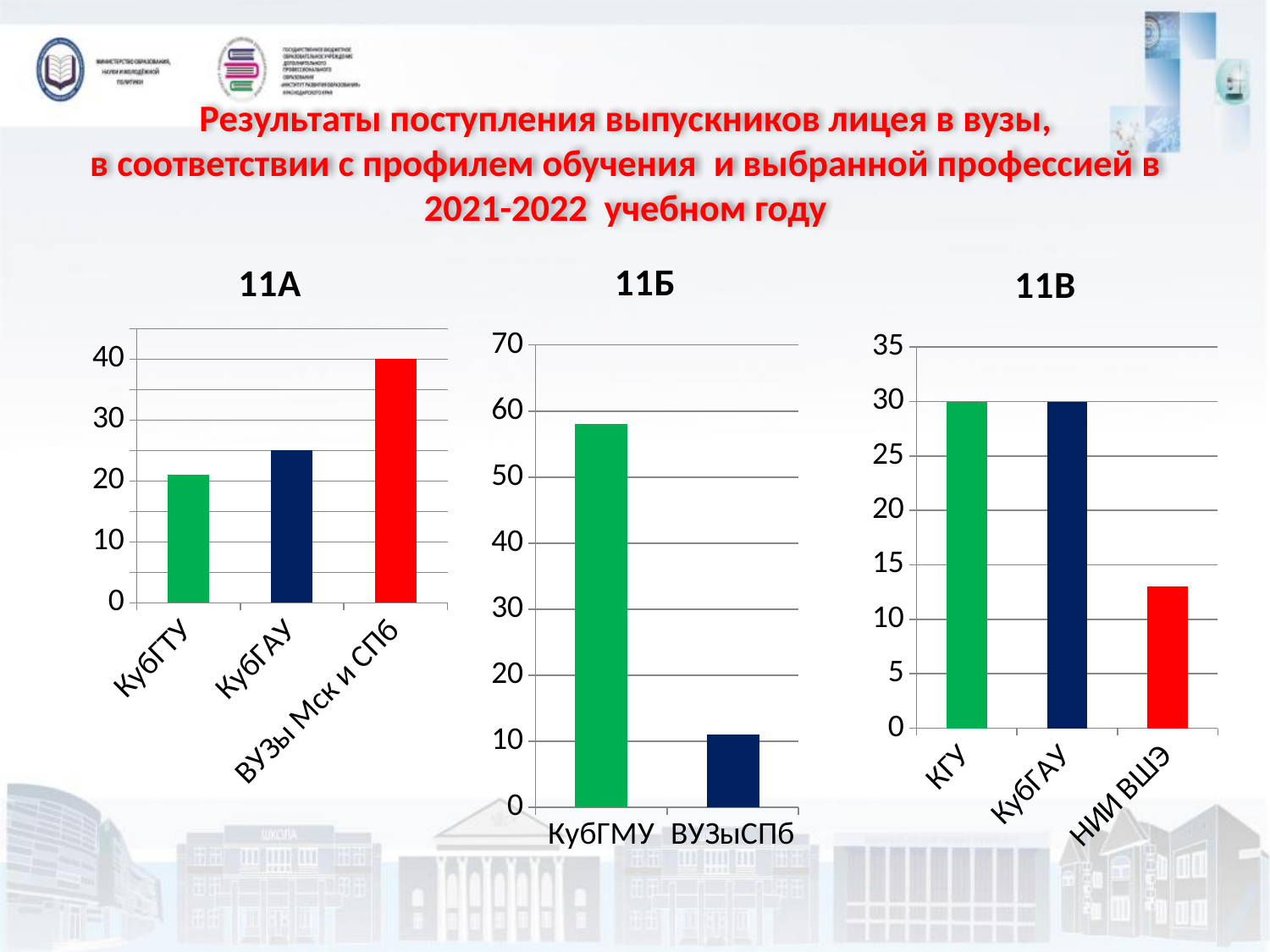
On the 11А chart, do the values rise or fall from left to right along the x axis? rise On the 11Б chart, is the value for КубГМУ greater or less than 50? greater On the 11Б chart, is the value for ВУЗыСПб greater or less than 20? less On the 11В chart, what is the value for КГУ? 30 How many categories are shown on the 11Б chart? 2 On the 11А chart, which category has the highest value? ВУЗы Мск и СПб What kind of chart is the 11В chart? bar chart On the 11А chart, what is the value for ВУЗы Мск и СПб? 40 On the 11В chart, which category has the lowest value? НИИ ВШЭ On the 11А chart, which is larger, the value for КубГАУ or the value for КубГТУ? КубГАУ On the 11Б chart, which category has the lowest value? ВУЗыСПб On the 11В chart, is the value for НИИ ВШЭ greater or less than 15? less